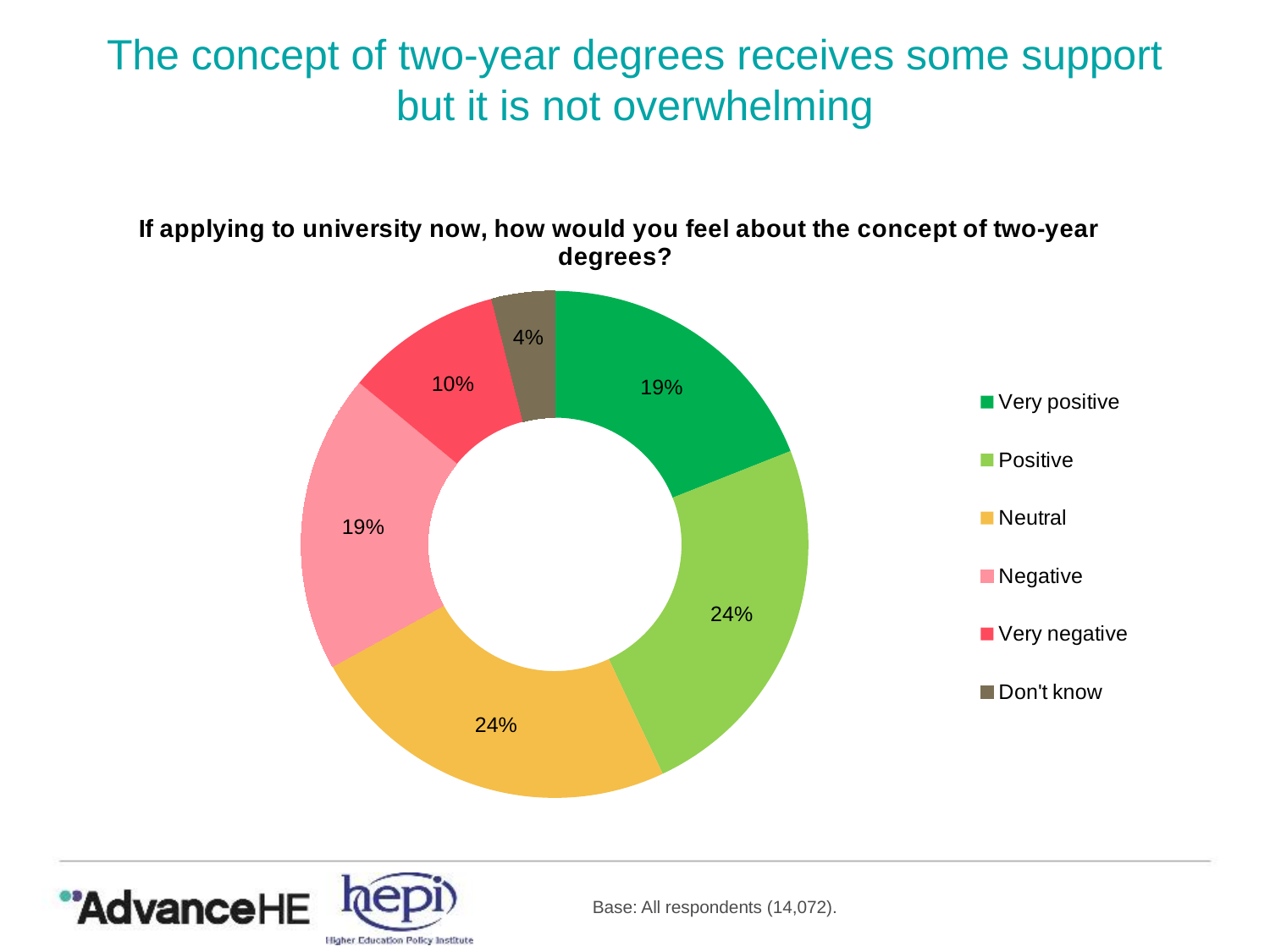
How many response categories does the chart show? 6 What is the combined share of 'Negative' and 'Very negative' responses? 29% What percentage of respondents answered 'Neutral'? 24% What is the difference in percentage points between 'Positive' and 'Very negative'? 14 What colour represents the 'Neutral' category in the chart? Yellow/orange What is the combined share of 'Very positive' and 'Positive' responses? 43% Which is larger, the share for 'Negative' or the share for 'Very negative'? Negative Which response category has the smallest share of the chart? Don't know What percentage of respondents said 'Very negative'? 10% What share of respondents answered 'Don't know'? 4% What percentage of respondents said they would feel 'Very positive' about the concept of two-year degrees? 19% What kind of chart is shown on the slide? Doughnut (pie) chart